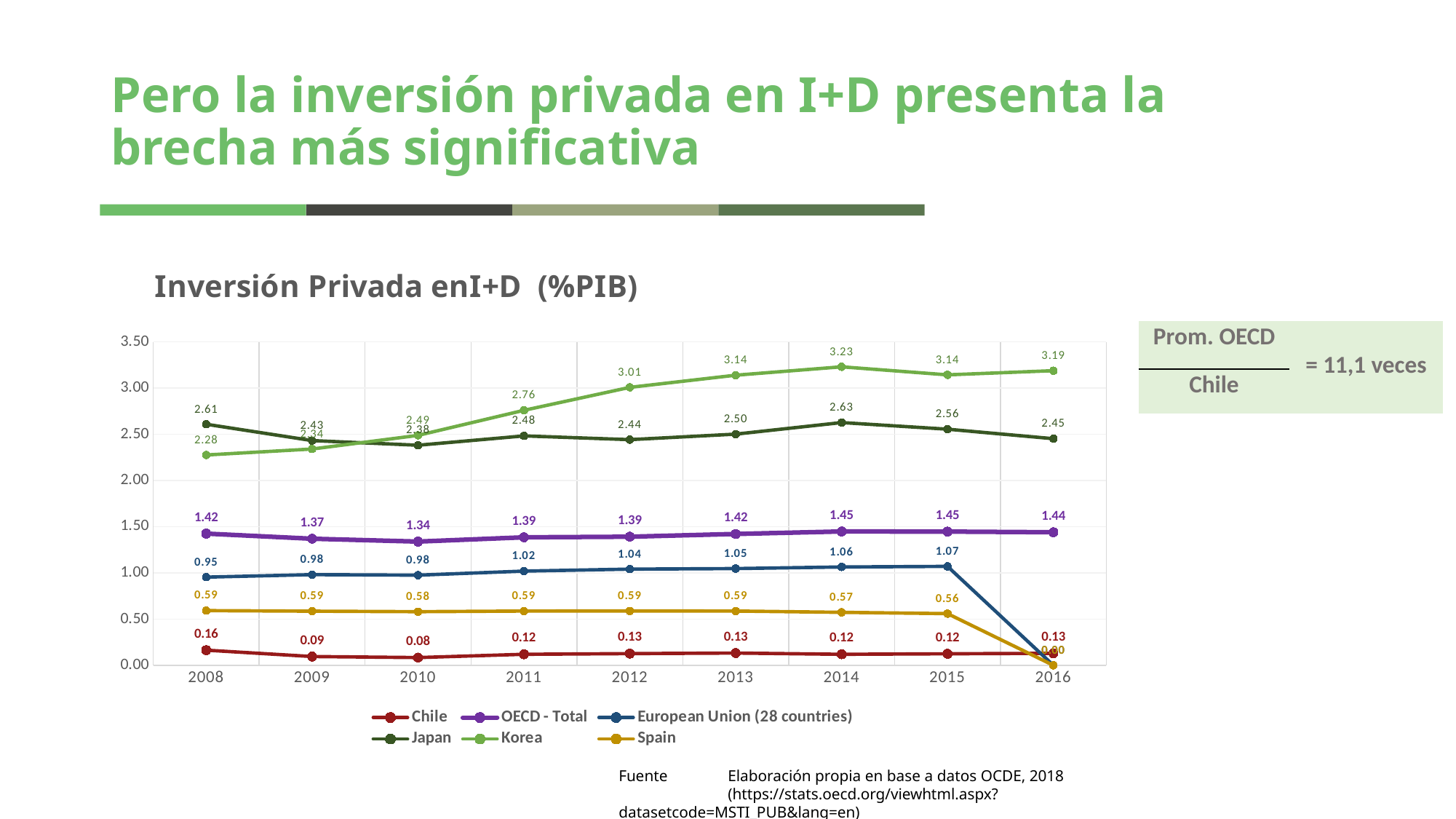
In which year does Chile have its lowest value? 2010 What is the value for Korea in 2014? 3.23 How many series does the legend list? 6 In which year does Korea reach its highest value? 2014 How many years are shown on the x axis? 9 What is the value for OECD - Total in 2015? 1.45 What is the value for Chile in 2010? 0.08 What kind of chart is shown on the slide? line chart Does the value for Korea rise or fall from 2008 to 2014? rise What is the difference between Japan's and Chile's values in 2008? 2.45 Which had the higher value in 2008, Japan or Korea? Japan Is the value for OECD - Total in 2012 greater or less than 1.50? less